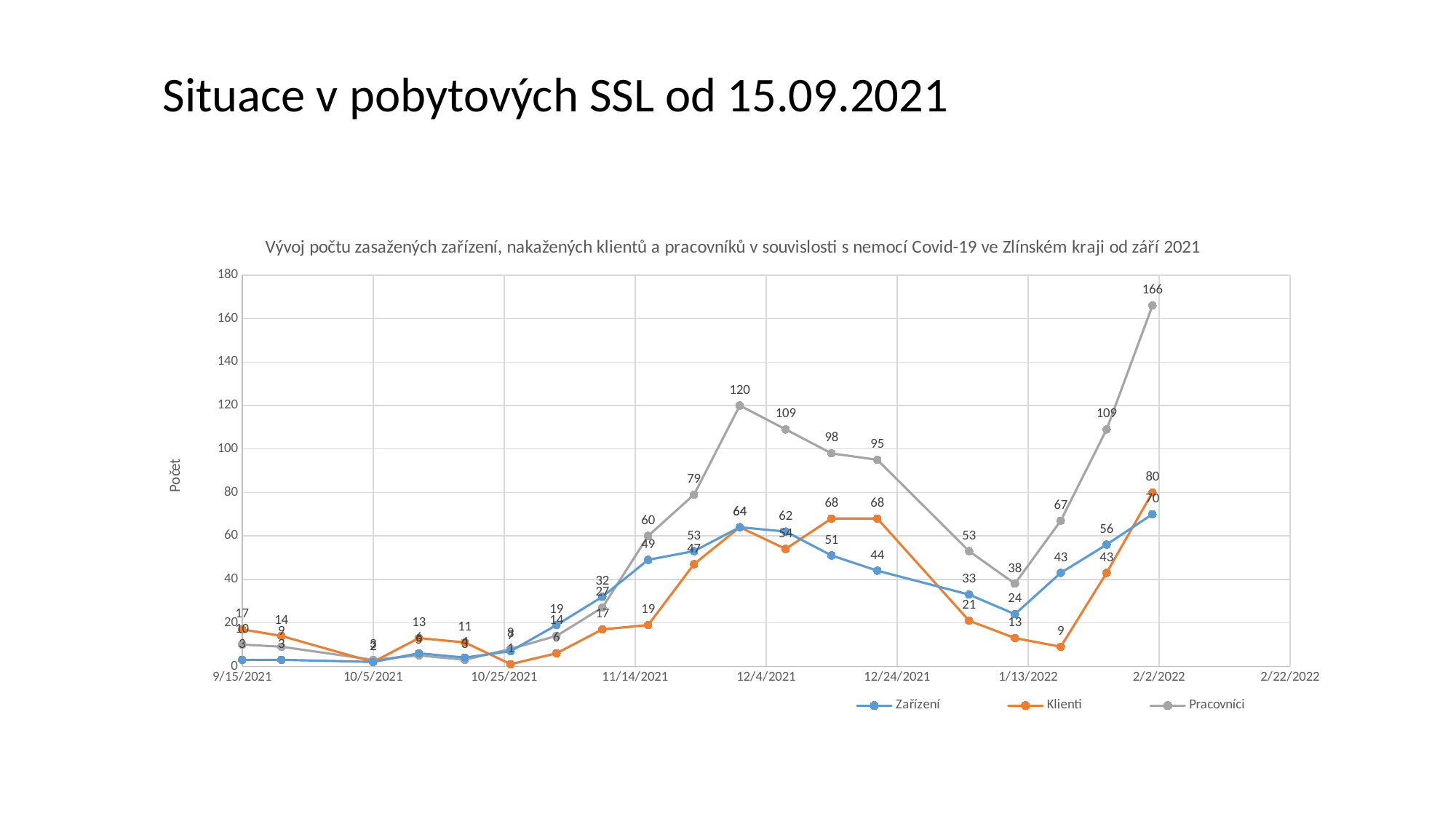
How many series does the legend list? 3 Is the highest value of the Pracovníci series greater or less than 160? greater What is the highest labeled value of the Pracovníci series? 166 What type of chart is shown on the slide? line chart At the last plotted point, which is larger: Klienti or Zařízení? Klienti What is the difference between the peak value of Pracovníci (166) and the peak value of Klienti (80)? 86 What is the label on the vertical axis? Počet What is the second-highest labeled value of the Pracovníci series? 120 What is the highest labeled value of the Zařízení series? 70 Which series reaches the highest value on the chart? Pracovníci Does the Pracovníci series rise or fall between its 120 peak and its 38 point? fall What is the highest labeled value of the Klienti series? 80